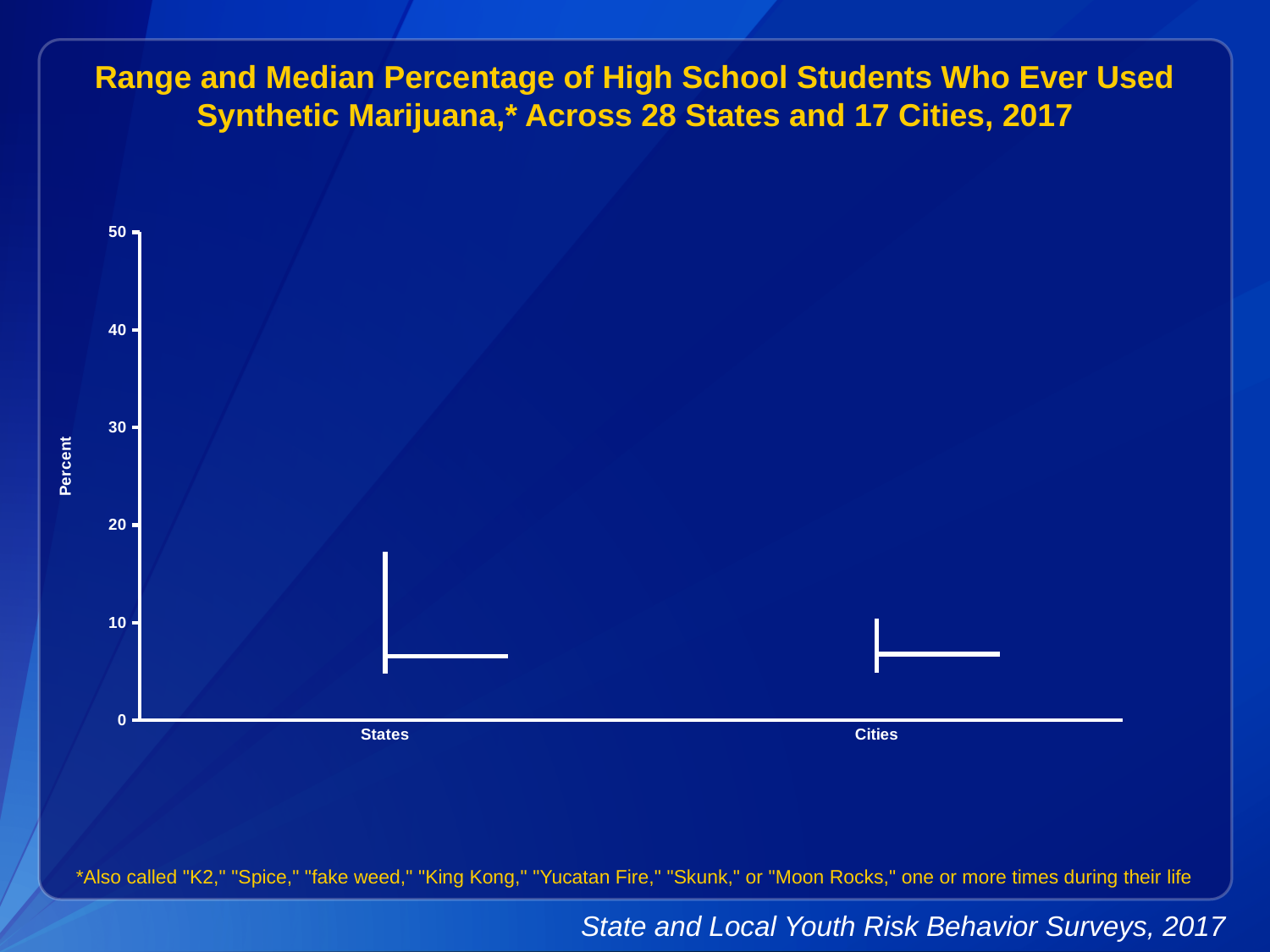
Which category has the higher maximum value of its range, States or Cities? States Is the median value for Cities greater or less than 10? less What is the label on the vertical axis? Percent What is the highest value shown on the vertical axis? 50 What is the title of the chart? Range and Median Percentage of High School Students Who Ever Used Synthetic Marijuana,* Across 28 States and 17 Cities, 2017 How many categories are shown on the x axis? 2 Is the median value for States greater or less than 10? less Is the top of the range for States greater or less than 20? less